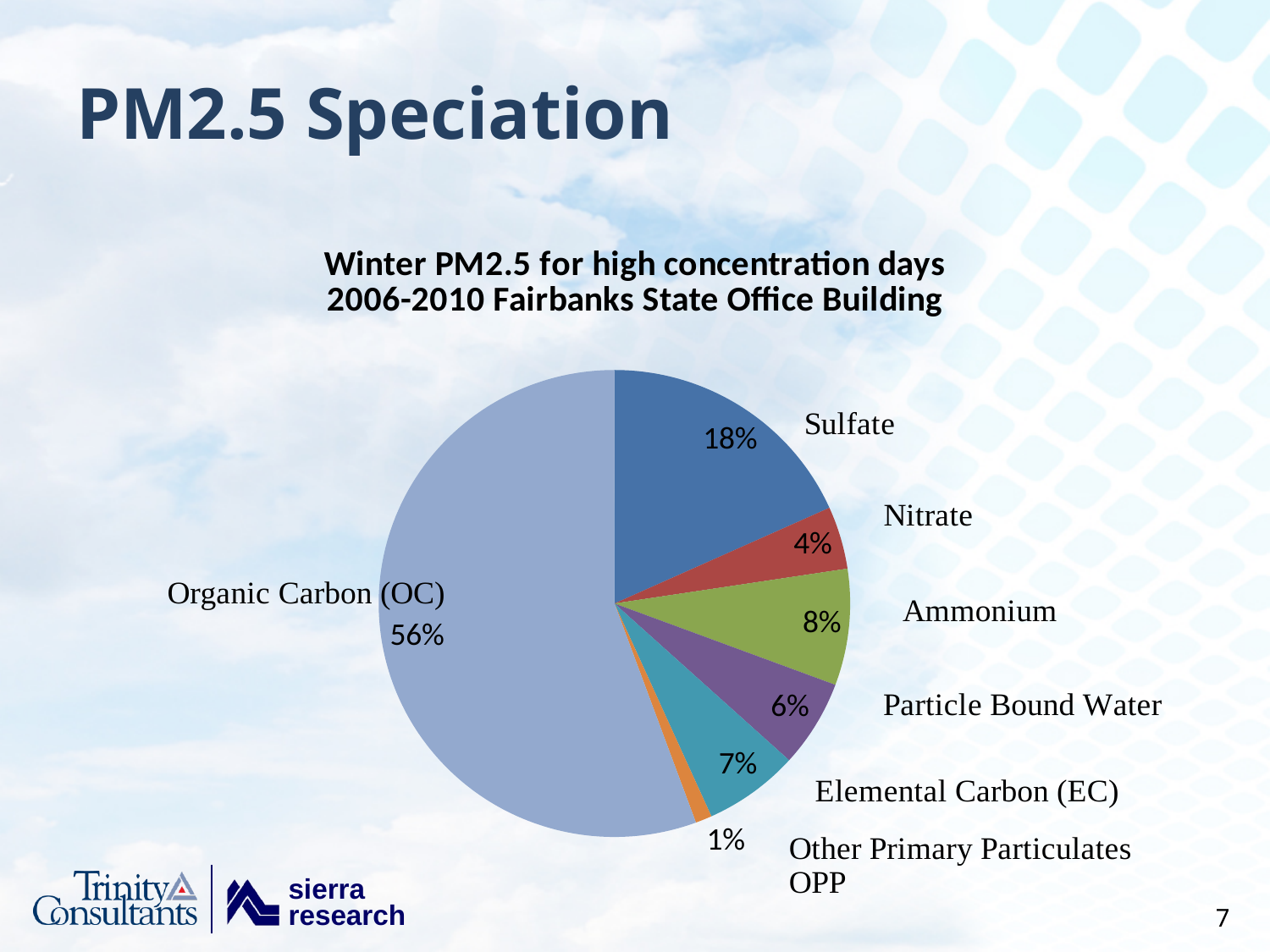
What kind of chart is shown on the slide? pie chart What is the combined share of Sulfate and Ammonium? 26% What is the value shown for Ammonium? 8% What is the value shown for Elemental Carbon (EC)? 7% Which category has the largest slice of the pie? Organic Carbon (OC) What is the value shown for Sulfate? 18% How many categories are shown in the pie chart? 7 What is the difference between the Sulfate and Nitrate shares? 14% Which is larger, the share for Particle Bound Water or the share for Nitrate? Particle Bound Water Which category has the smallest slice of the pie? Other Primary Particulates OPP What share of the pie does Organic Carbon (OC) have? 56% What is the title of the pie chart? Winter PM2.5 for high concentration days 2006-2010 Fairbanks State Office Building